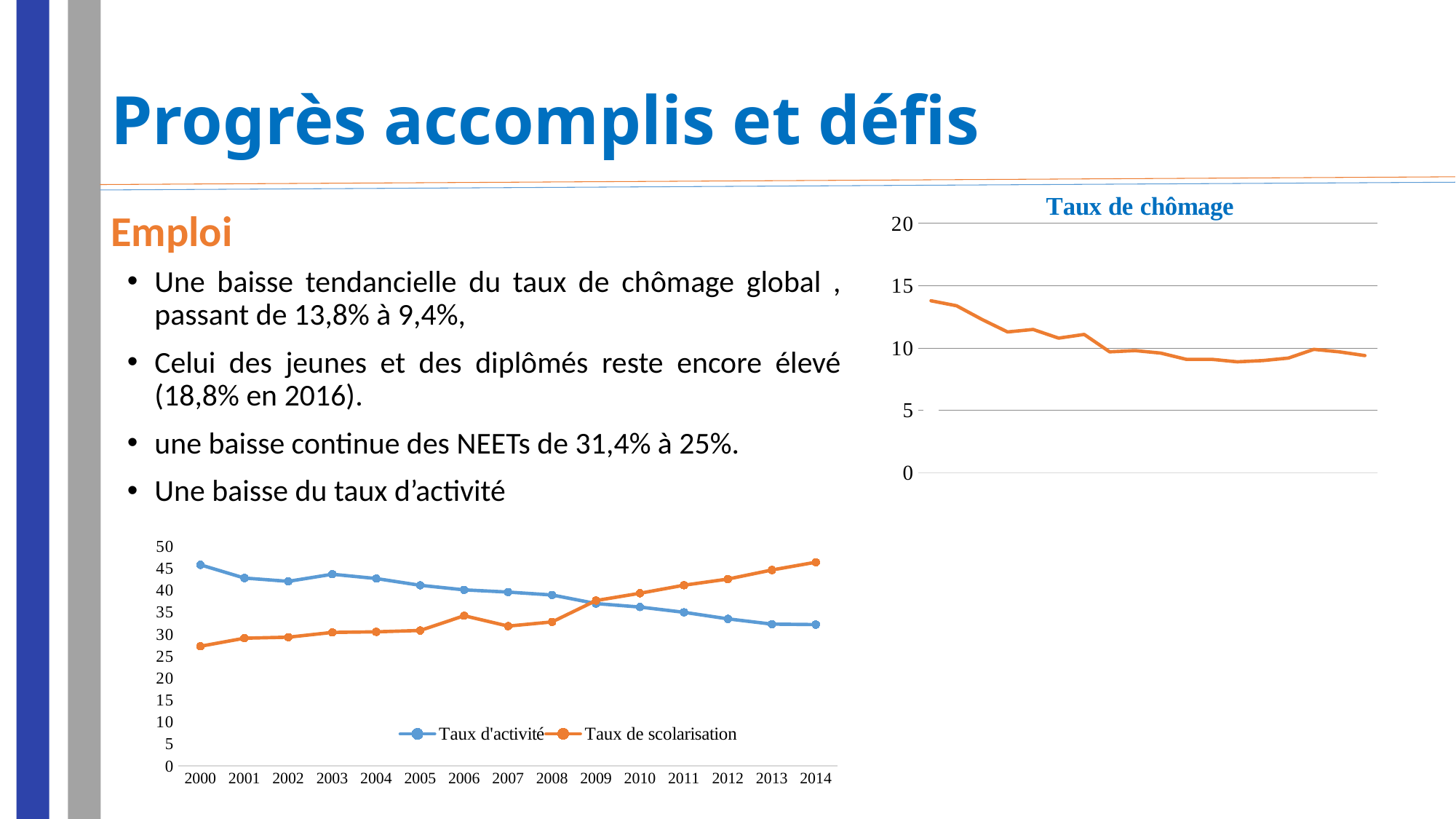
In the 'Taux de chômage' chart, is the last value greater or less than 10? less What kind of chart is the bottom-left chart with years 2000 to 2014? line chart In the 'Taux de chômage' chart, do the values rise or fall along the x axis overall? fall How many years are shown on the x axis of the bottom-left chart? 15 In the 'Taux de chômage' chart, is the first value greater or less than 10? greater How many series does the legend of the bottom-left chart list? 2 In the bottom-left chart, does 'Taux d'activité' rise or fall from 2000 to 2014? fall In the bottom-left chart, is the value of 'Taux de scolarisation' in 2000 greater or less than 30? less What kind of chart is the 'Taux de chômage' chart? line chart In the bottom-left chart, which series is higher in 2014, 'Taux d'activité' or 'Taux de scolarisation'? Taux de scolarisation In the bottom-left chart, does 'Taux de scolarisation' rise or fall from 2000 to 2014? rise